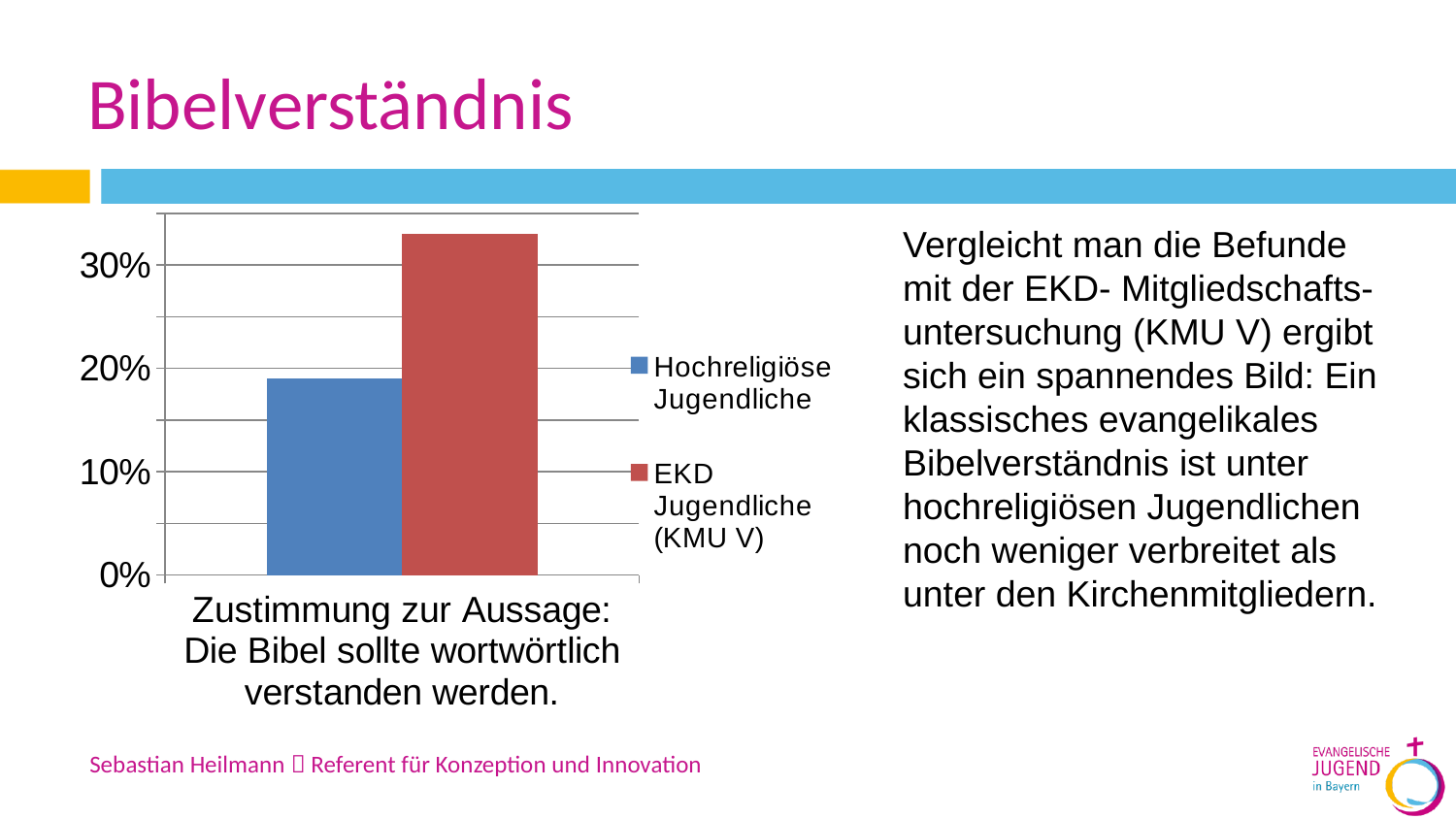
What is the category label shown under the bars on the x axis? Zustimmung zur Aussage: Die Bibel sollte wortwörtlich verstanden werden. Which series has the highest bar in the chart? EKD Jugendliche (KMU V) Is the value for Hochreligiöse Jugendliche greater or less than 10%? greater Which series has the higher value: Hochreligiöse Jugendliche or EKD Jugendliche (KMU V)? EKD Jugendliche (KMU V) Is the value for EKD Jugendliche (KMU V) greater or less than 20%? greater How many categories are shown on the x axis of the chart? 1 What kind of chart is shown on the slide? bar chart What colour is the bar for EKD Jugendliche (KMU V)? red Is the value for EKD Jugendliche (KMU V) greater or less than 30%? greater How many series does the chart legend list? 2 Which series has the lowest bar in the chart? Hochreligiöse Jugendliche